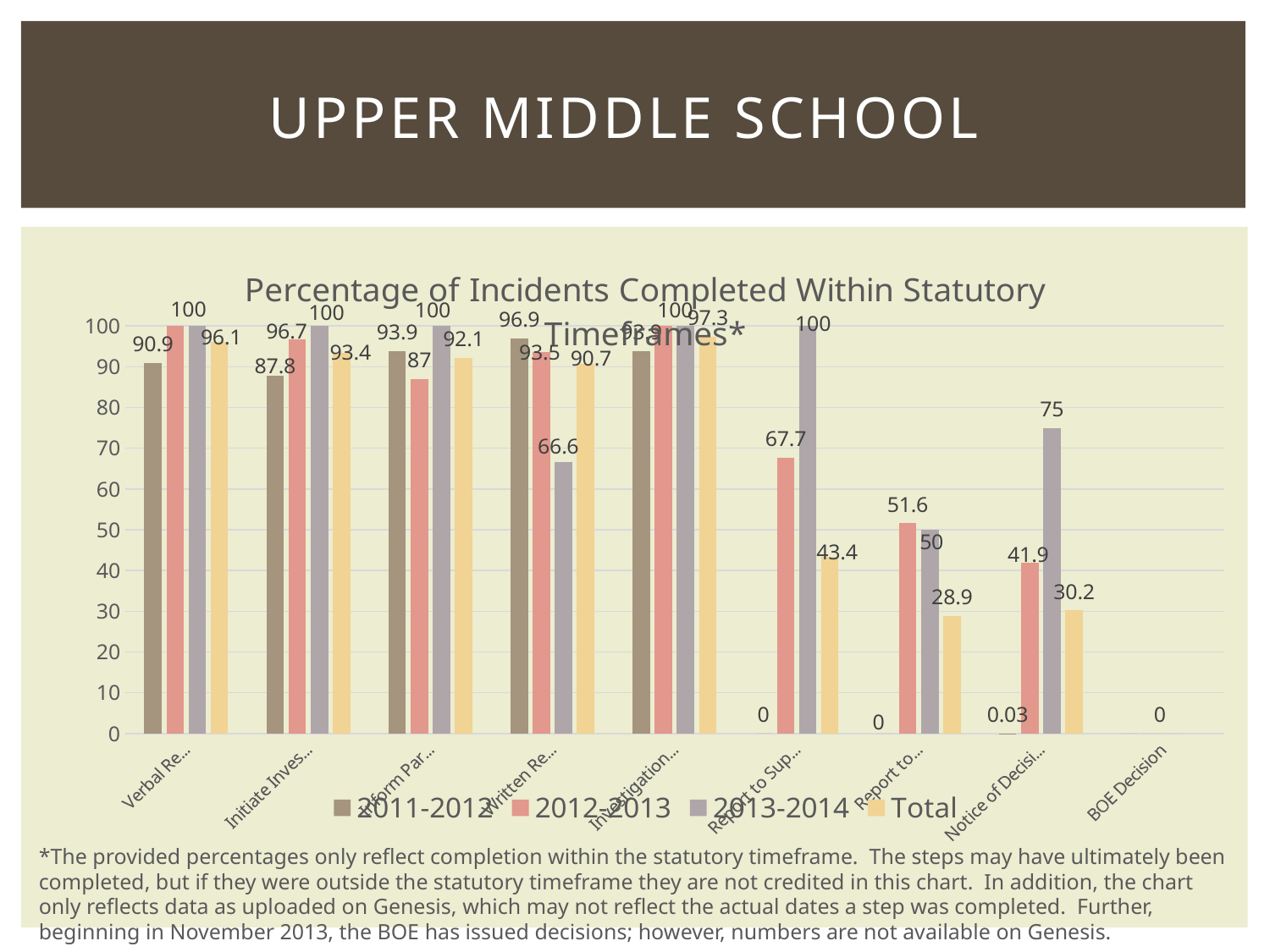
What is the title of the chart? Percentage of Incidents Completed Within Statutory Timeframes* What kind of chart is shown on the slide? Bar chart How many series does the chart legend list? 4 What is the 2011-2012 value for the category labelled 'Initiate Inves...'? 87.8 What is the 2013-2014 value for the category labelled 'Written Re...'? 66.6 For the 2012-2013 series, which is larger: the value for 'Report to Sup...' or the value for 'Report to...'? Report to Sup... What is the Total value for the category labelled 'Report to Sup...'? 43.4 Within the category labelled 'Notice of Decisi...', which series has the highest value? 2013-2014 In the category labelled 'Notice of Decisi...', what is the difference between the 2013-2014 value and the 2012-2013 value? 33.1 What is the 2012-2013 value for the category labelled 'Notice of Decisi...'? 41.9 Is the Total value for the category labelled 'Notice of Decisi...' greater or less than 40? less How many categories are shown along the x axis of the chart? 9